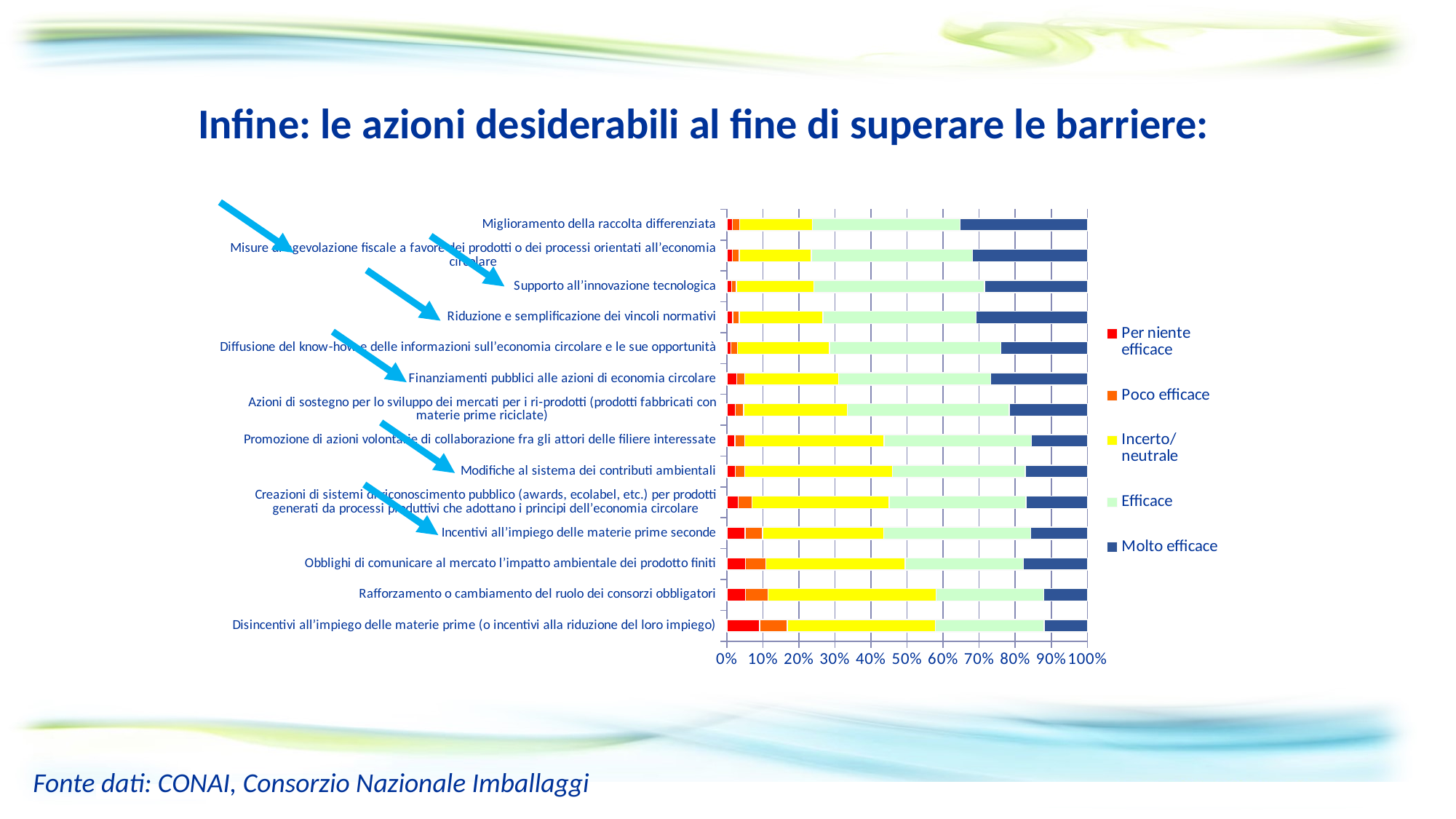
Is the 'Molto efficace' segment for 'Miglioramento della raccolta differenziata' greater or less than 30%? greater What kind of chart is shown on the slide? Stacked bar chart Which category is listed first (at the top) of the chart? Miglioramento della raccolta differenziata How many series does the chart legend list? 5 Is the 'Per niente efficace' segment for 'Miglioramento della raccolta differenziata' greater or less than 10%? less Is the 'Incerto/neutrale' segment for 'Disincentivi all'impiego delle materie prime (o incentivi alla riduzione del loro impiego)' greater or less than 30%? greater How many categories (actions) are listed on the vertical axis of the chart? 14 Which category has the largest 'Per niente efficace' segment? Disincentivi all'impiego delle materie prime (o incentivi alla riduzione del loro impiego) Which has the larger 'Molto efficace' segment: 'Miglioramento della raccolta differenziata' or 'Disincentivi all'impiego delle materie prime (o incentivi alla riduzione del loro impiego)'? Miglioramento della raccolta differenziata Which colour represents 'Molto efficace' in the legend? Dark blue What is the maximum value shown on the horizontal axis of the chart? 100%